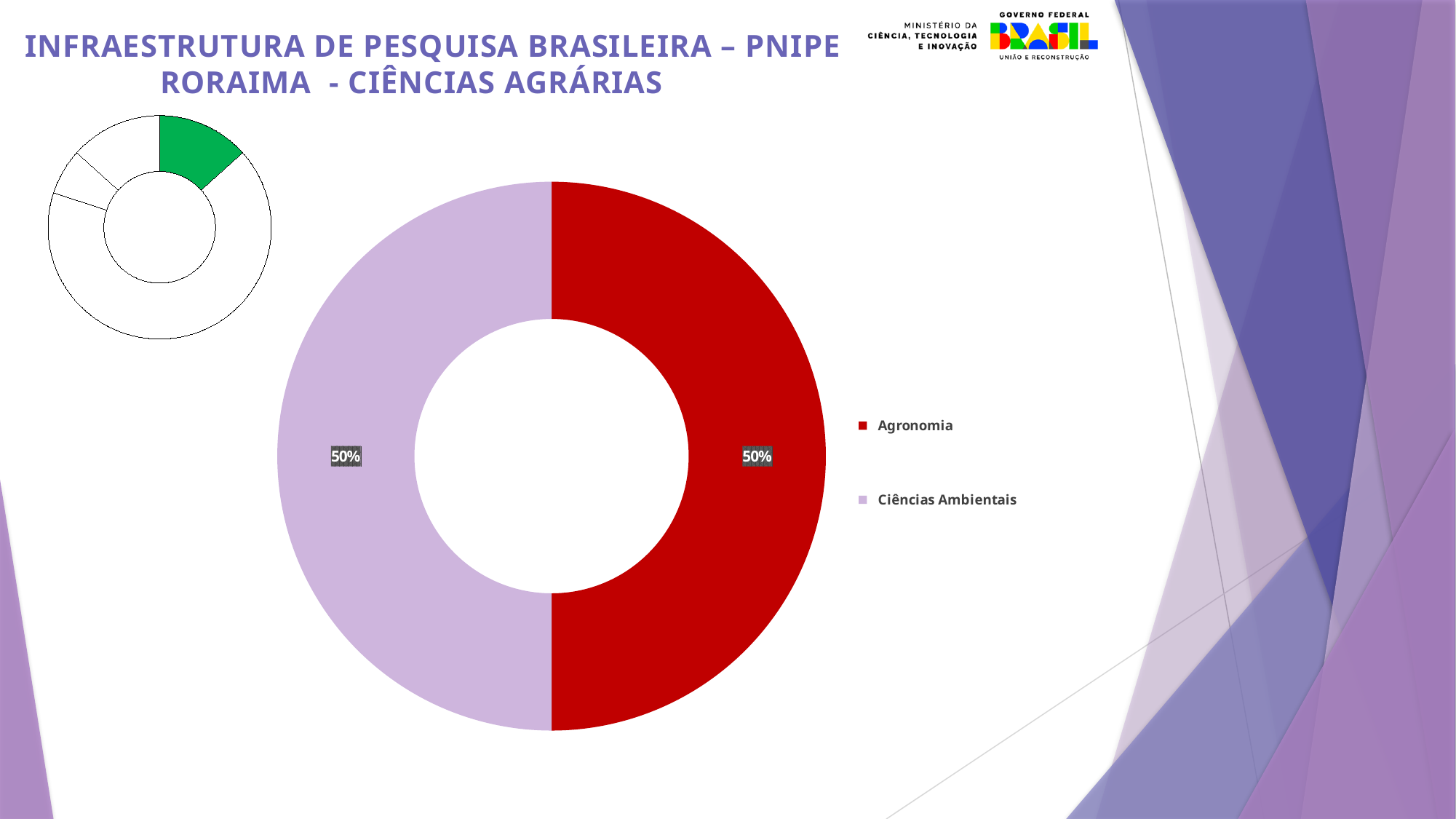
Which category is shown in red in the main donut chart? Agronomia How many entries does the legend of the main donut chart list? 2 What share of the main donut chart does Ciências Ambientais represent? 50% Is the share for Agronomia in the main donut chart greater or less than 25%? greater How many categories does the main donut chart show? 2 What kind of chart is the main chart on the slide? Donut chart What is the difference between the shares of Agronomia and Ciências Ambientais in the main donut chart? 0% Is the share for Ciências Ambientais in the main donut chart greater or less than 75%? less What is the combined share of Agronomia and Ciências Ambientais in the main donut chart? 100% Which is larger in the main donut chart, Agronomia or Ciências Ambientais? They are equal What share of the main donut chart does Agronomia represent? 50% Which category is shown in light purple in the main donut chart? Ciências Ambientais